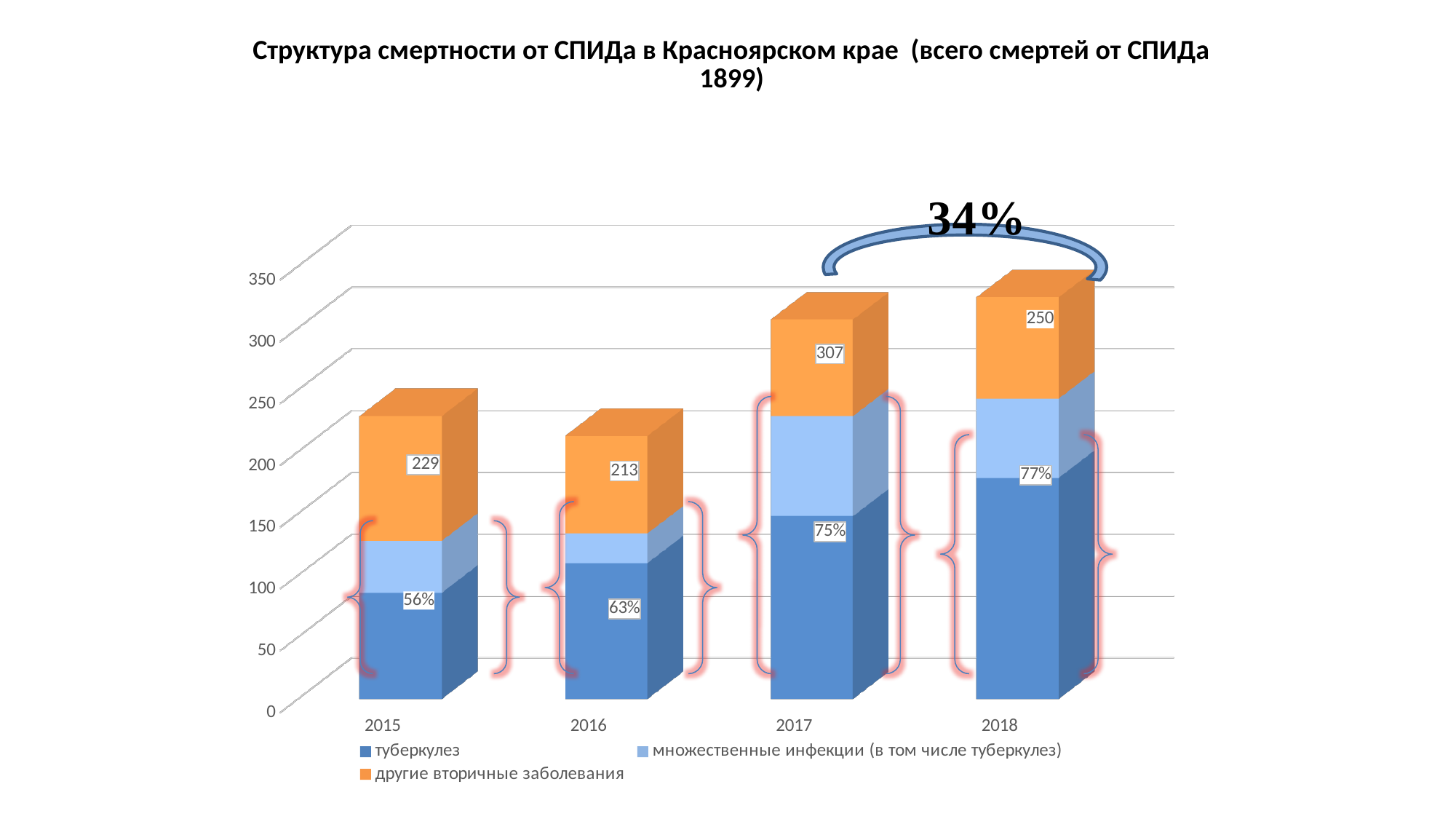
What type of chart is shown on the slide? stacked bar chart How many series does the legend list? 3 What percentage is written in the annotation above the 2017 and 2018 bars? 34% Which year has the highest percentage label on the туберкулез segment? 2018 What percentage label is shown on the туберкулез segment for 2015? 56% What percentage label is shown on the туберкулез segment for 2018? 77% How many years (categories) are shown on the x axis? 4 Do the percentage labels on the туберкулез segments rise or fall from 2015 to 2018? rise What value label is shown on the другие вторичные заболевания segment for 2017? 307 What is the difference between the value labels on the другие вторичные заболевания segments for 2017 and 2016? 94 What value label is shown on the другие вторичные заболевания segment for 2016? 213 Which year has the lowest percentage label on the туберкулез segment? 2015